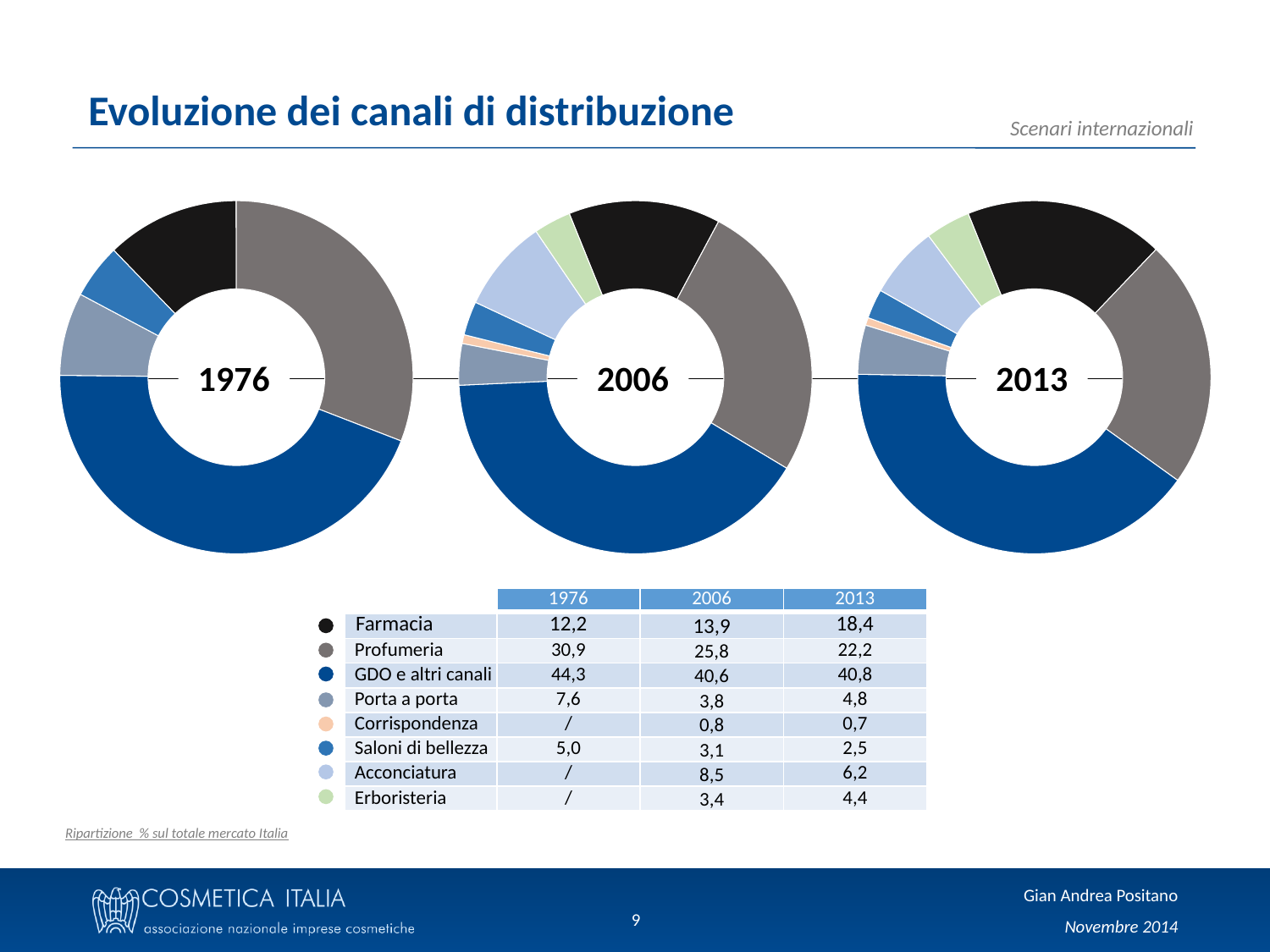
How many donut charts are on the slide? 3 How many channels (slices) does the 1976 chart contain? 5 In the 2013 chart, which channel has the largest share? GDO e altri canali What kind of charts are shown on the slide? Donut (pie) charts Does the Profumeria share rise or fall from 1976 to 2013? Fall How many channels are listed in the legend table? 8 In the 2006 chart, what is the share for Acconciatura? 8,5 How much larger is the Farmacia share in 2013 than in 1976? 6,2 In the 2013 chart, which is larger: Porta a porta or Erboristeria? Porta a porta In the 2006 chart, which channel has the smallest share? Corrispondenza In the 2013 chart, what is the share for Farmacia? 18,4 In the 1976 chart, what is the share for GDO e altri canali? 44,3